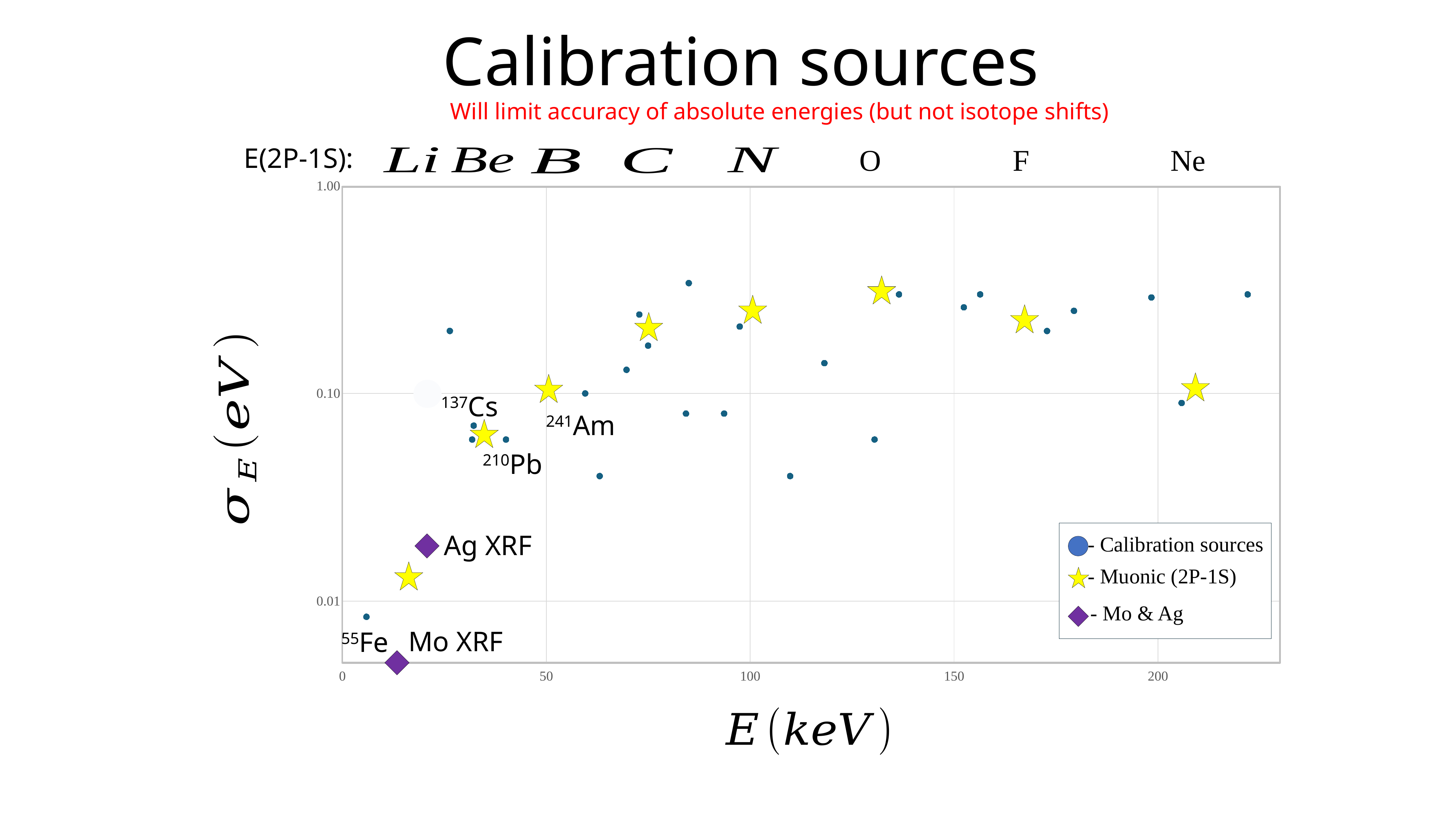
What is the label of the x axis? E (keV) Is the value for 210Pb greater or less than 0.10? less How many series does the legend list? 3 Is the value for Mo XRF greater or less than 0.01? less Which has the larger σ_E value, Ag XRF or Mo XRF? Ag XRF What kind of chart is shown on the slide? scatter plot How many Muonic (2P-1S) star markers are plotted? 8 How many Mo & Ag diamond markers are plotted? 2 Which element's Muonic (2P-1S) star has the lowest σ_E value? Li What are the three series named in the legend? Calibration sources, Muonic (2P-1S), Mo & Ag Is the value for Ag XRF greater or less than 0.01? greater